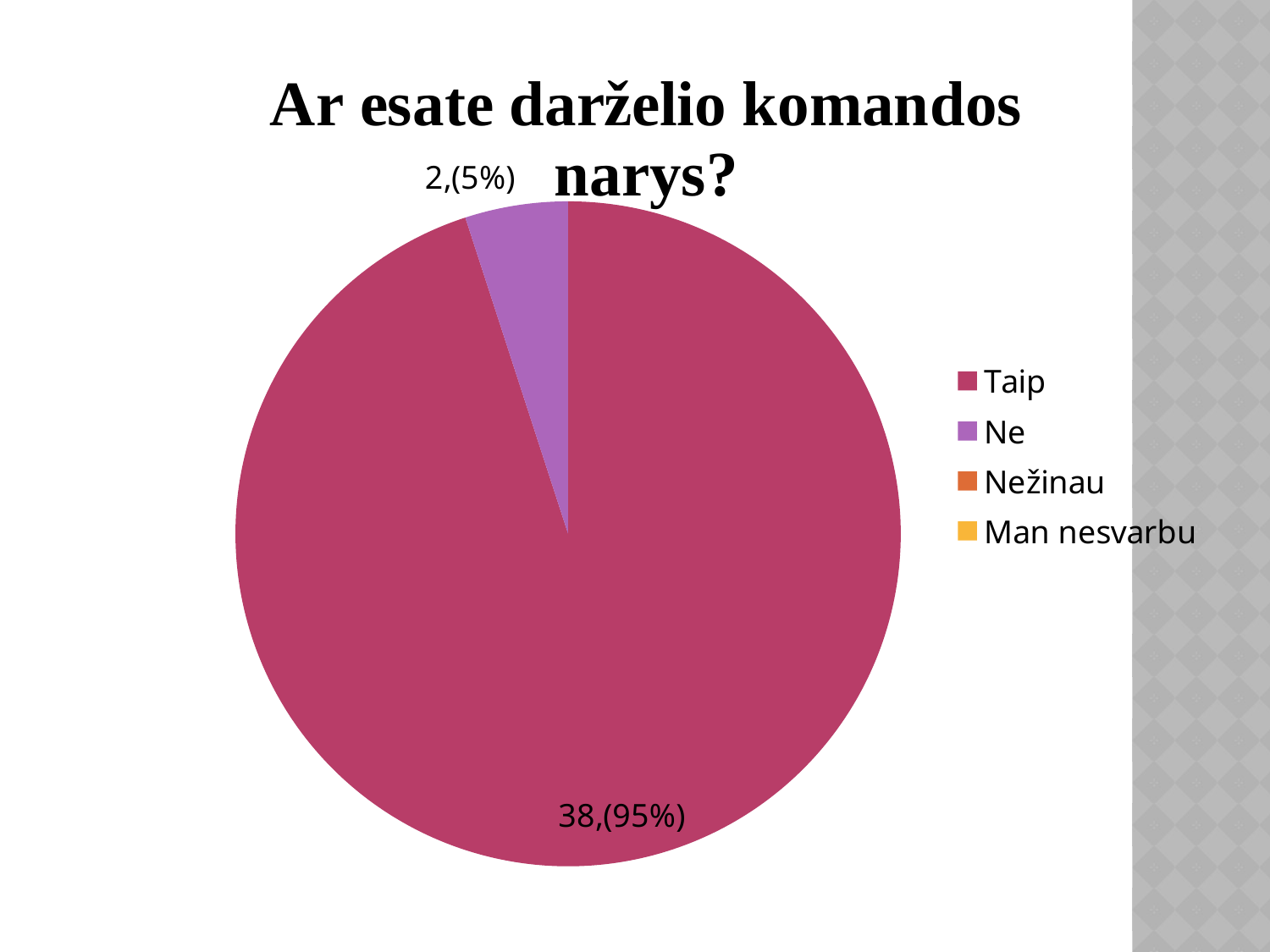
What is the data label shown for the Taip slice? 38,(95%) Which of the two labelled slices is larger, Taip or Ne? Taip What is the difference in count between the Taip and Ne slices? 36 What is the title of the chart? Ar esate darželio komandos narys? What kind of chart is shown on the slide? pie chart Which legend entry is shown in purple? Ne How many entries does the legend list? 4 What is the data label shown for the Ne slice? 2,(5%) What share of the pie does the Ne slice represent? 5% What is the total count of the Taip and Ne slices combined? 40 Which category has the largest slice of the pie? Taip What share of the pie does the Taip slice represent? 95%